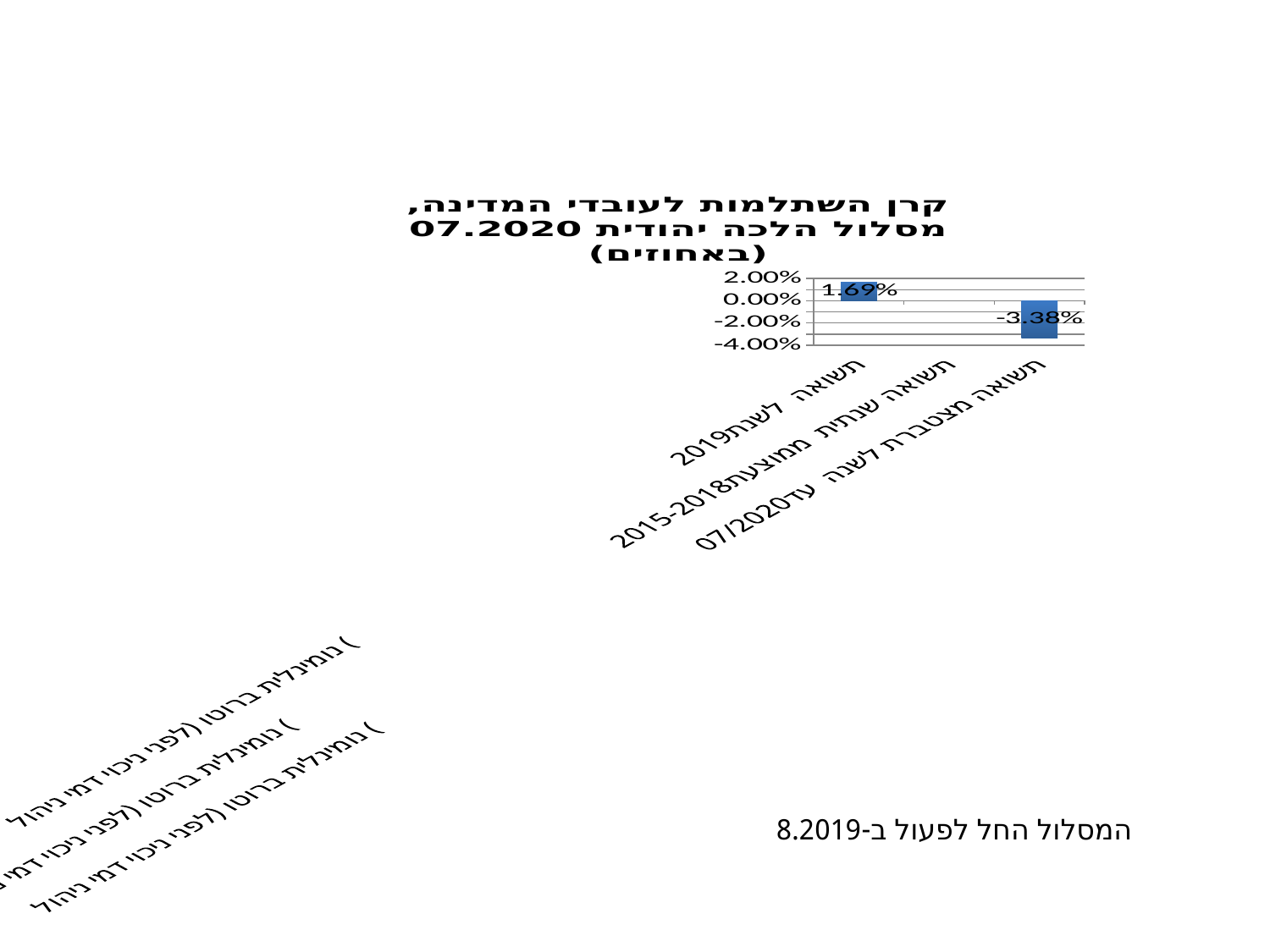
Which category has the highest value? תשואה לשנת 2019 What is the value for תשואה מצטברת לשנה עד 07/2020? -3.38% Which category has the lowest value? תשואה מצטברת לשנה עד 07/2020 How many categories are shown on the x axis of the chart? 3 Is the value for תשואה מצטברת לשנה עד 07/2020 greater or less than -2.00%? less What is the value for תשואה לשנת 2019? 1.69% Which is larger, the value for תשואה לשנת 2019 or the value for תשואה מצטברת לשנה עד 07/2020? תשואה לשנת 2019 What kind of chart is shown on the slide? bar chart Is the value for תשואה לשנת 2019 greater or less than 0.00%? greater What is the difference between the value for תשואה לשנת 2019 and the value for תשואה מצטברת לשנה עד 07/2020? 5.07% What is the title of the chart? קרן השתלמות לעובדי המדינה, מסלול הלכה יהודית 07.2020 (באחוזים) What is the lowest value shown on the y axis of the chart? -4.00%